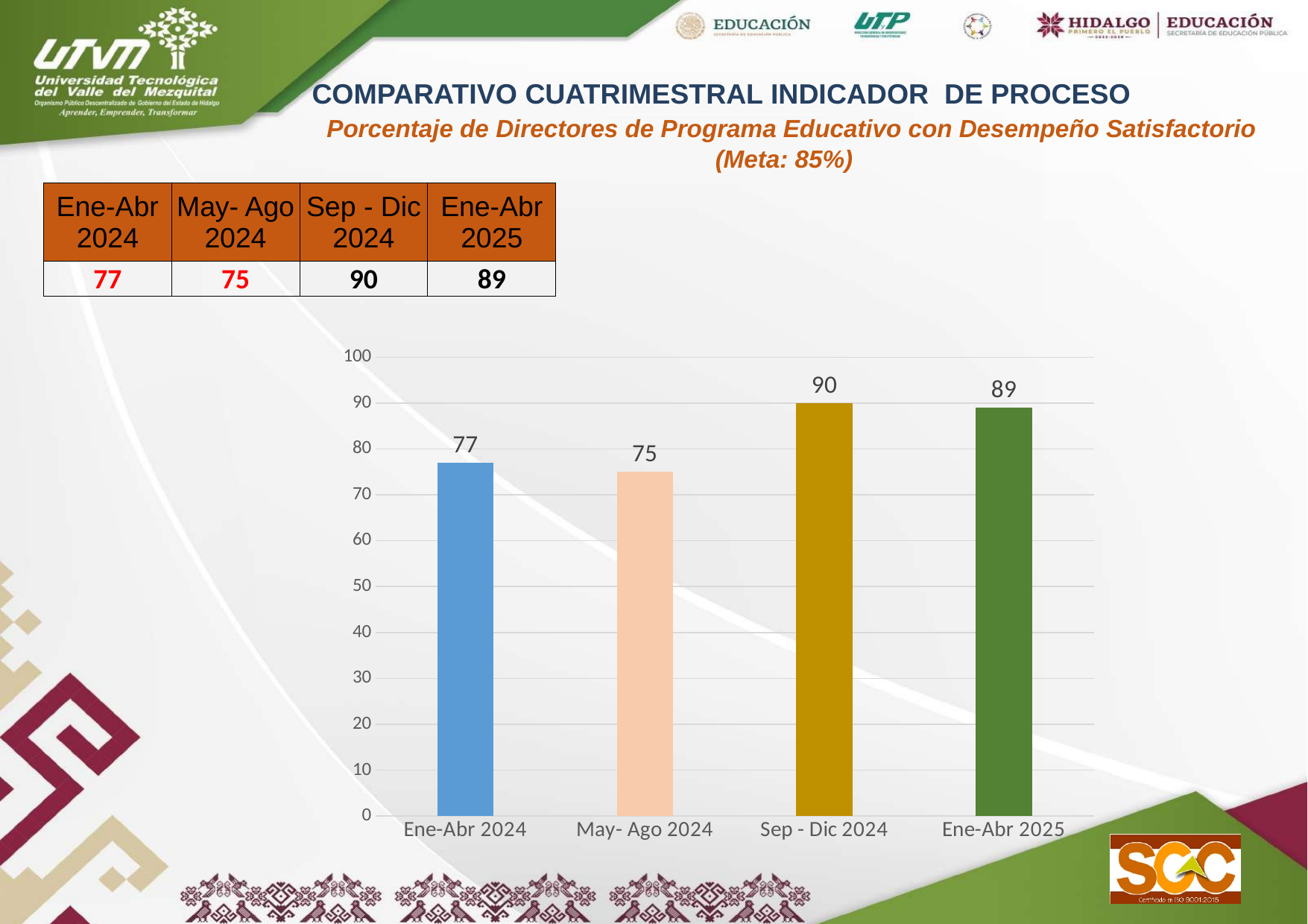
Which period has the highest value? Sep - Dic 2024 What is the value for May- Ago 2024? 75 What is the difference between the values for Sep - Dic 2024 and May- Ago 2024? 15 What kind of chart is shown on the slide? bar chart Which period has the lowest value? May- Ago 2024 What is the value for Sep - Dic 2024? 90 Which is larger, the value for Ene-Abr 2024 or the value for Ene-Abr 2025? Ene-Abr 2025 What is the target (Meta) stated in the slide subtitle? 85% What is the value for Ene-Abr 2025? 89 Is the value for Ene-Abr 2025 greater or less than 80? greater What is the value for Ene-Abr 2024? 77 How many periods are shown on the x axis of the chart? 4